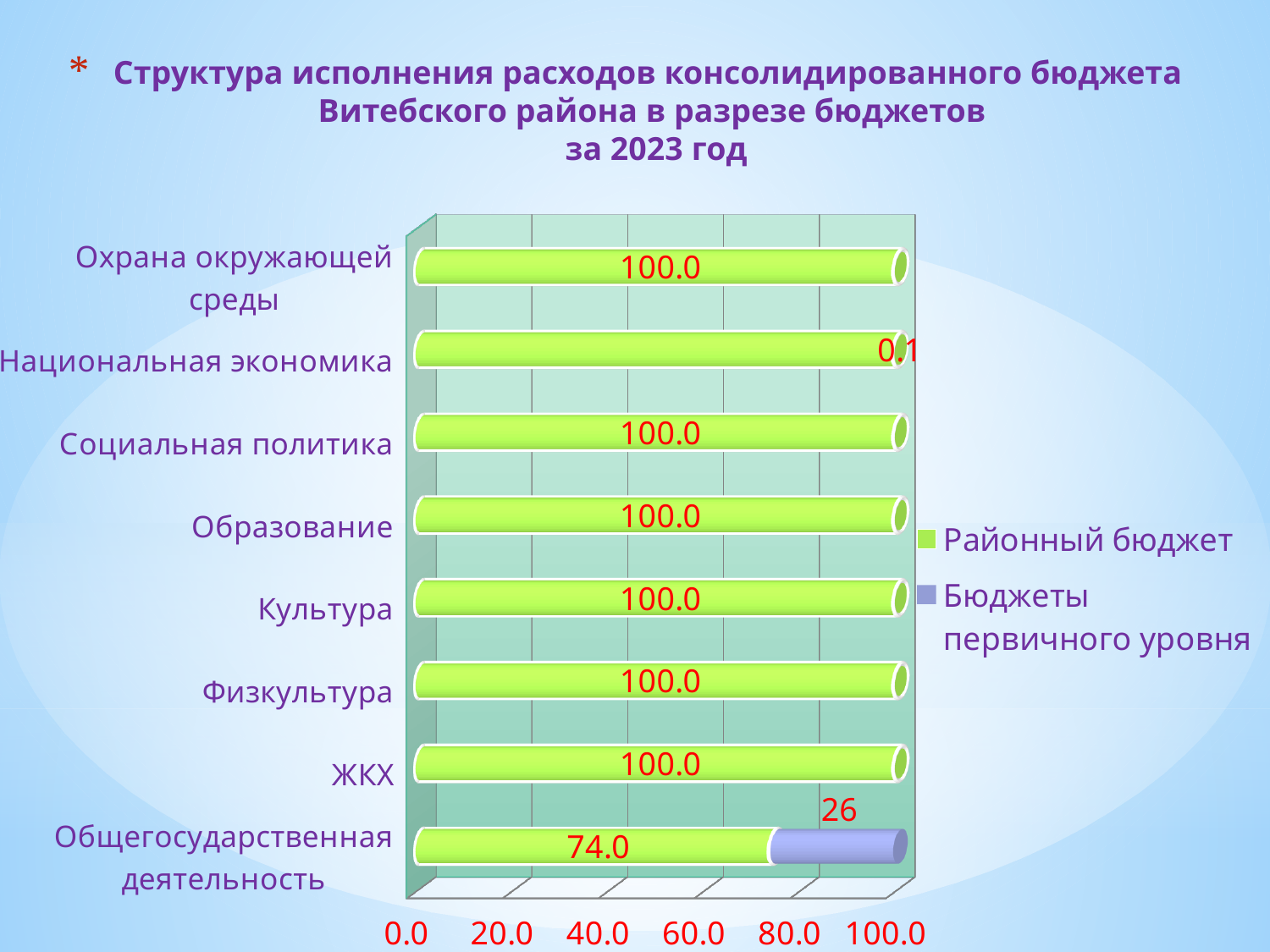
What is the value of Районный бюджет for ЖКХ? 100.0 How many series does the legend list? 2 Which two series are listed in the legend? Районный бюджет and Бюджеты первичного уровня What is the value of Бюджеты первичного уровня for Общегосударственная деятельность? 26 Which is larger: the Районный бюджет value for ЖКХ or for Общегосударственная деятельность? ЖКХ What kind of chart is shown on the slide? bar chart What is the value of Районный бюджет for Образование? 100.0 How many categories are shown on the chart? 8 Which category has the lowest value for Районный бюджет? Общегосударственная деятельность What is the difference between the Районный бюджет and Бюджеты первичного уровня values for Общегосударственная деятельность? 48 What is the value of Районный бюджет for Общегосударственная деятельность? 74.0 What is the total of the stacked bar for Общегосударственная деятельность? 100